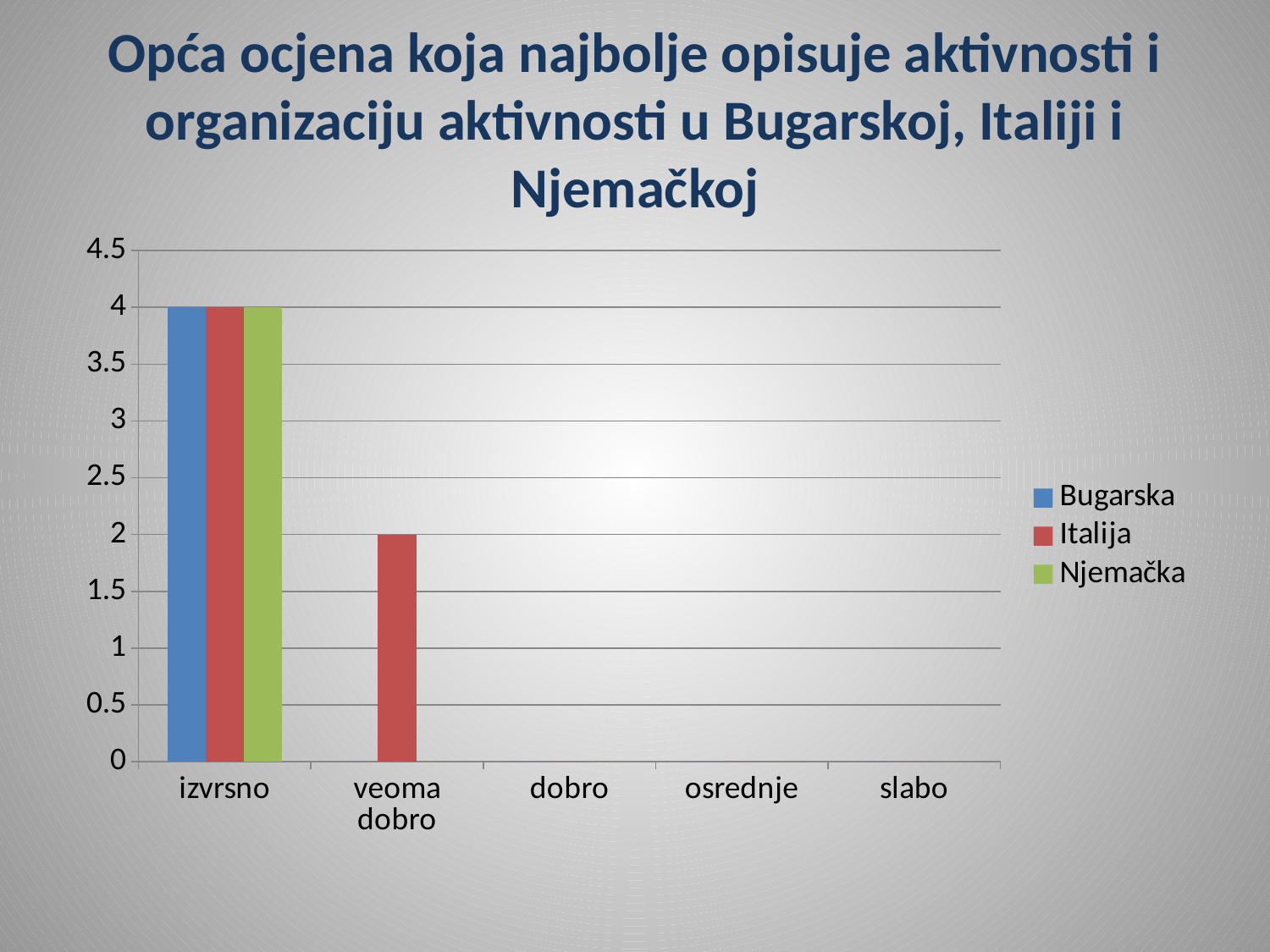
What is the difference between Italija's value for izvrsno and its value for veoma dobro? 2 What is the value for Italija in the veoma dobro category? 2 How many categories are shown on the x axis? 5 What is the value for Bugarska in the izvrsno category? 4 How many series does the legend list? 3 Is the value for Italija in the veoma dobro category greater or less than 3? less Which series is the only one with a bar in the veoma dobro category? Italija What kind of chart is shown on the slide? bar chart What is the value for Njemačka in the izvrsno category? 4 Which category has the highest value for Italija? izvrsno Which is larger: Italija's value for izvrsno or Italija's value for veoma dobro? izvrsno What colour represents Njemačka in the legend? green